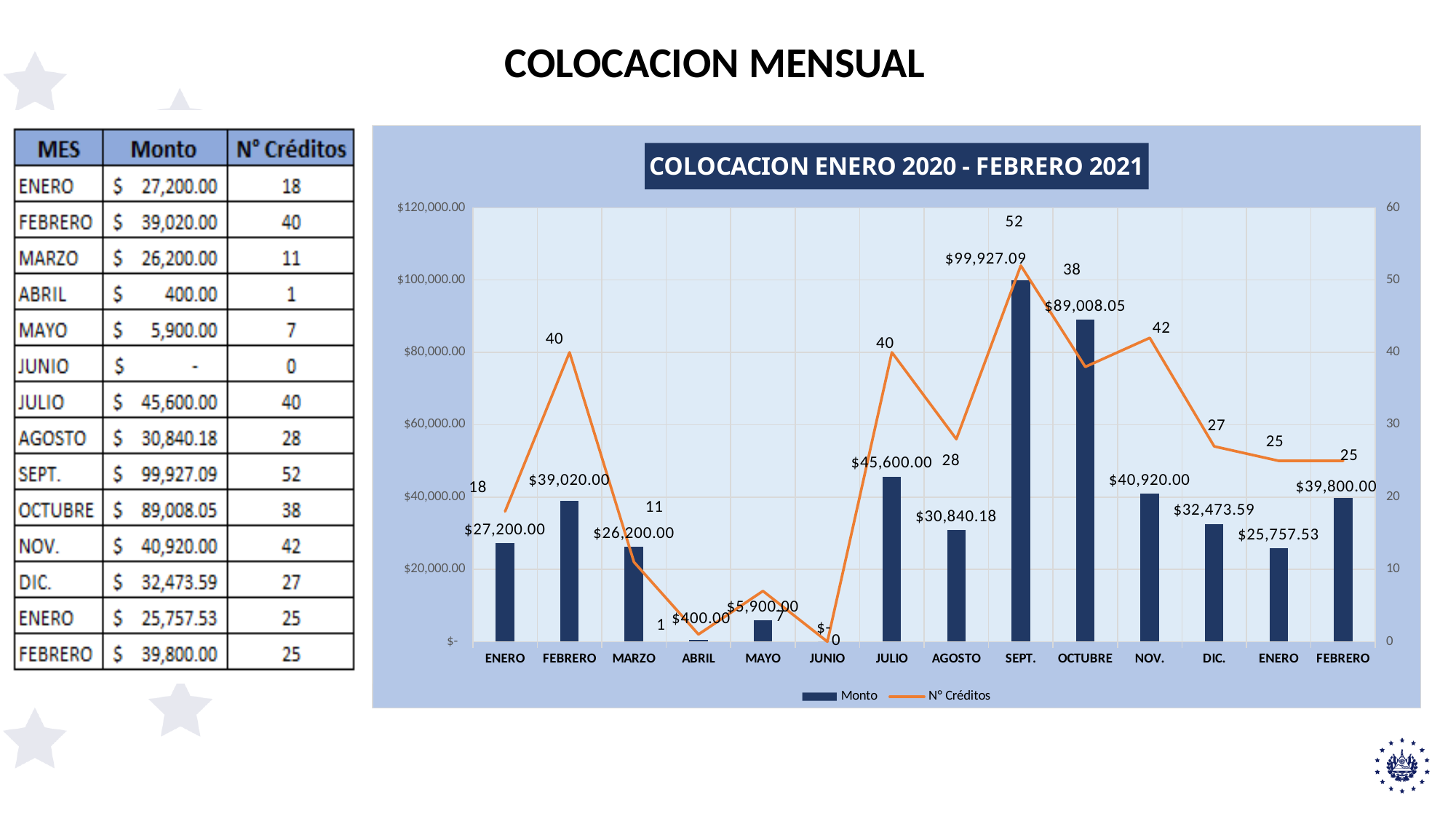
How many series does the chart legend list? 2 What is the difference in N° Créditos between the first FEBRERO and the first ENERO in the chart? 22 Which month has the larger Monto, JULIO or AGOSTO? JULIO What is the difference in Monto between SEPT. and OCTUBRE? $10,919.04 Which month has the highest N° Créditos value on the line? SEPT. What is the Monto value for MAYO in the chart? $5,900.00 What is the title of the chart? COLOCACION ENERO 2020 - FEBRERO 2021 What is the Monto value for SEPT. in the chart? $99,927.09 How many N° Créditos does the chart show for NOV.? 42 Which month has the highest Monto bar in the chart? SEPT. Which month has the lowest Monto in the chart? JUNIO How many months are plotted along the x axis of the chart? 14